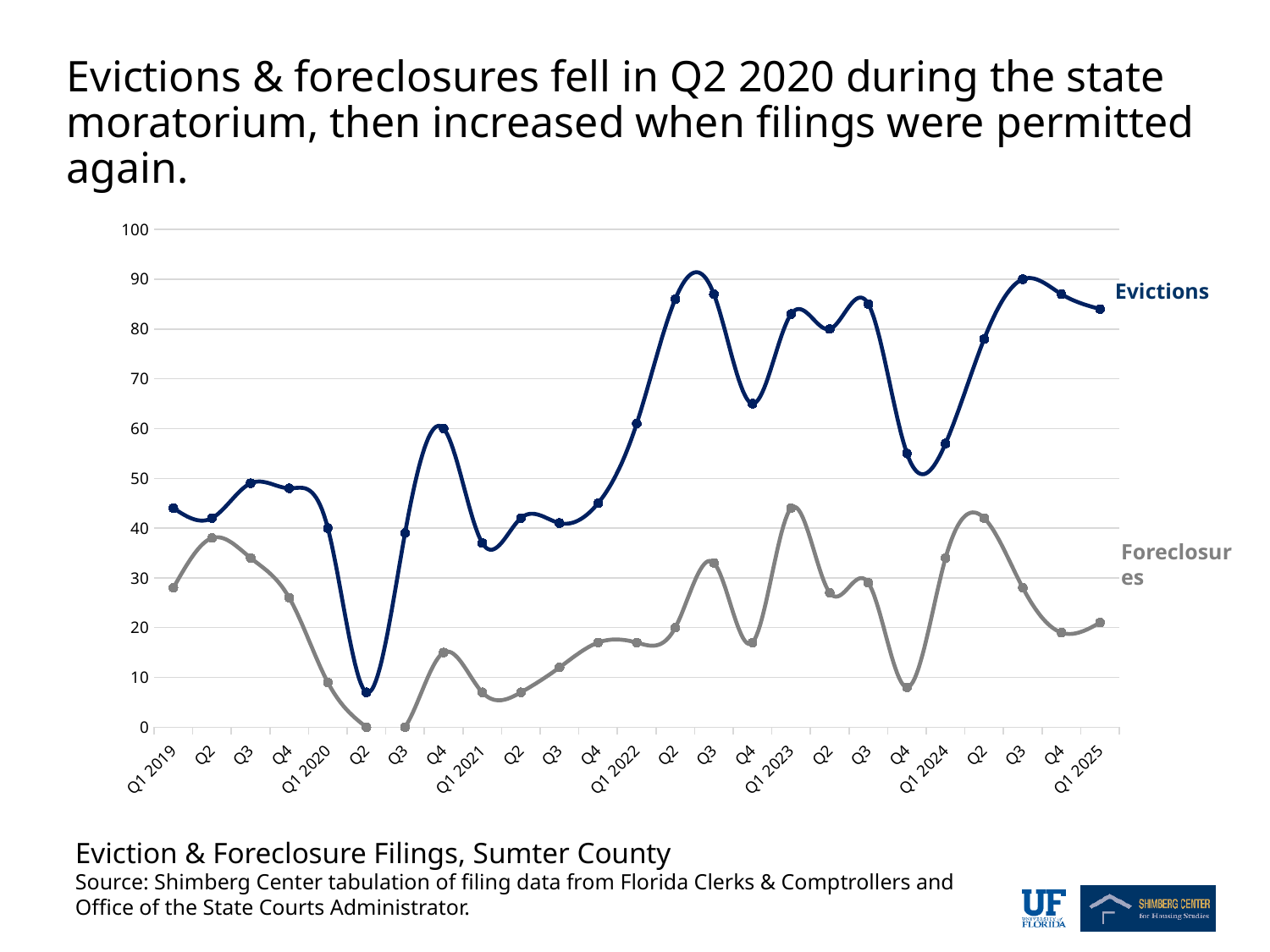
Is the Evictions value in Q2 2020 greater or less than 10? less How many quarters are plotted along the x axis, from Q1 2019 to Q1 2025? 25 In Q1 2019, which series has the higher value, Evictions or Foreclosures? Evictions How many series does the chart show? 2 What is the Foreclosures value in Q2 2020? 0 Is the Evictions value in Q2 2022 greater or less than 80? greater Do Evictions rise or fall from Q4 2023 to Q3 2024? Rise What is the title of the chart given below it? Eviction & Foreclosure Filings, Sumter County In which quarter is the Evictions value lowest? Q2 2020 Is the Evictions value in Q4 2023 greater or less than 60? less What kind of chart is shown on the slide? Line chart